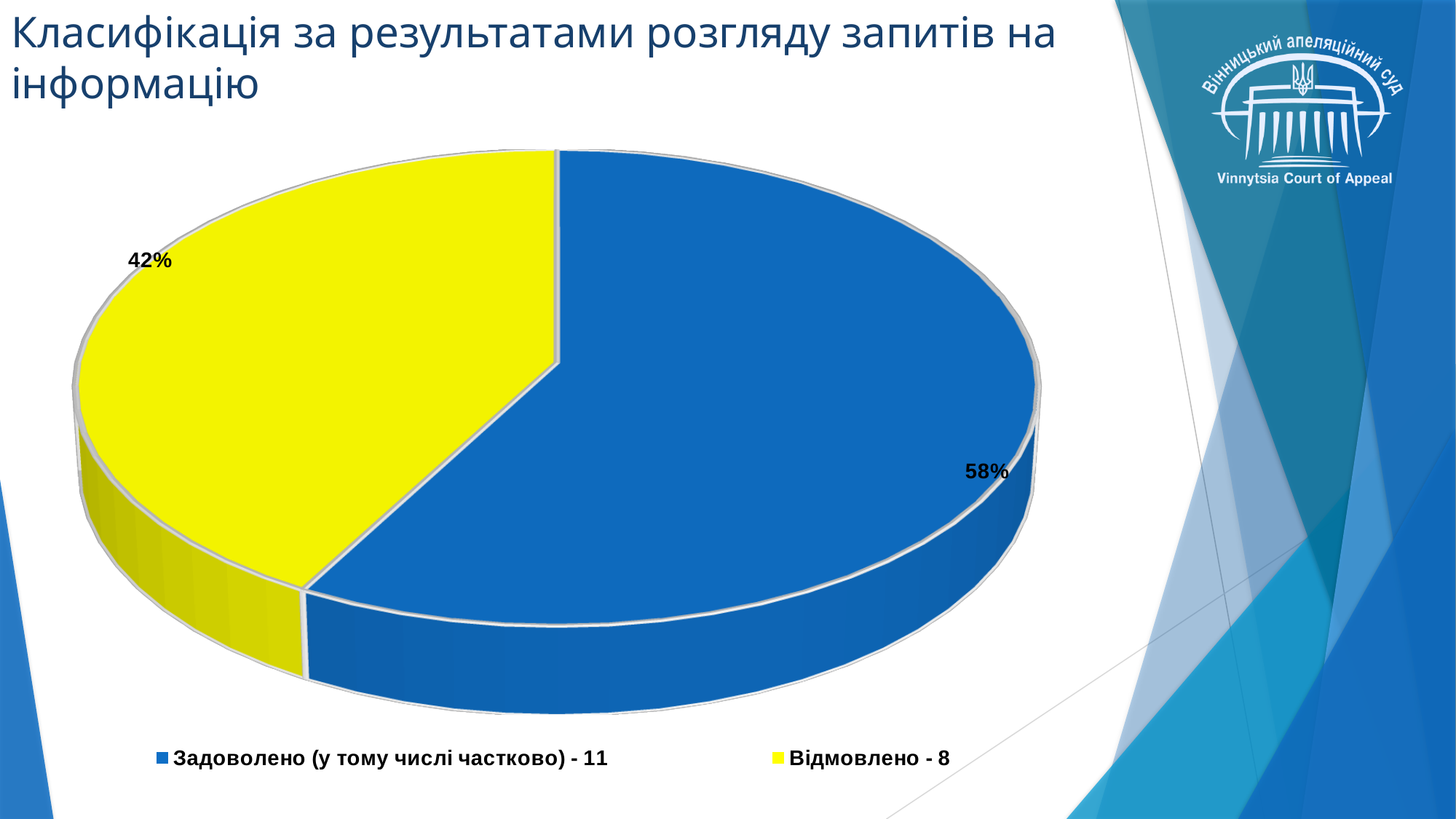
What share of the pie does the slice "Відмовлено - 8" represent? 42% What share of the pie does the slice "Задоволено (у тому числі частково) - 11" represent? 58% Is the share for "Відмовлено" greater or less than 50%? less How many slices does the pie chart have? 2 What is the title of the slide containing the pie chart? Класифікація за результатами розгляду запитів на інформацію How many entries does the legend list? 2 Which slice of the pie is the largest? Задоволено (у тому числі частково) - 11 Which is larger: the share for "Задоволено (у тому числі частково)" or the share for "Відмовлено"? Задоволено (у тому числі частково) What colour is the "Відмовлено - 8" slice? yellow What kind of chart is shown on the slide? pie chart What is the difference in percentage points between the "Задоволено (у тому числі частково)" slice and the "Відмовлено" slice? 16 percentage points Which slice of the pie is the smallest? Відмовлено - 8